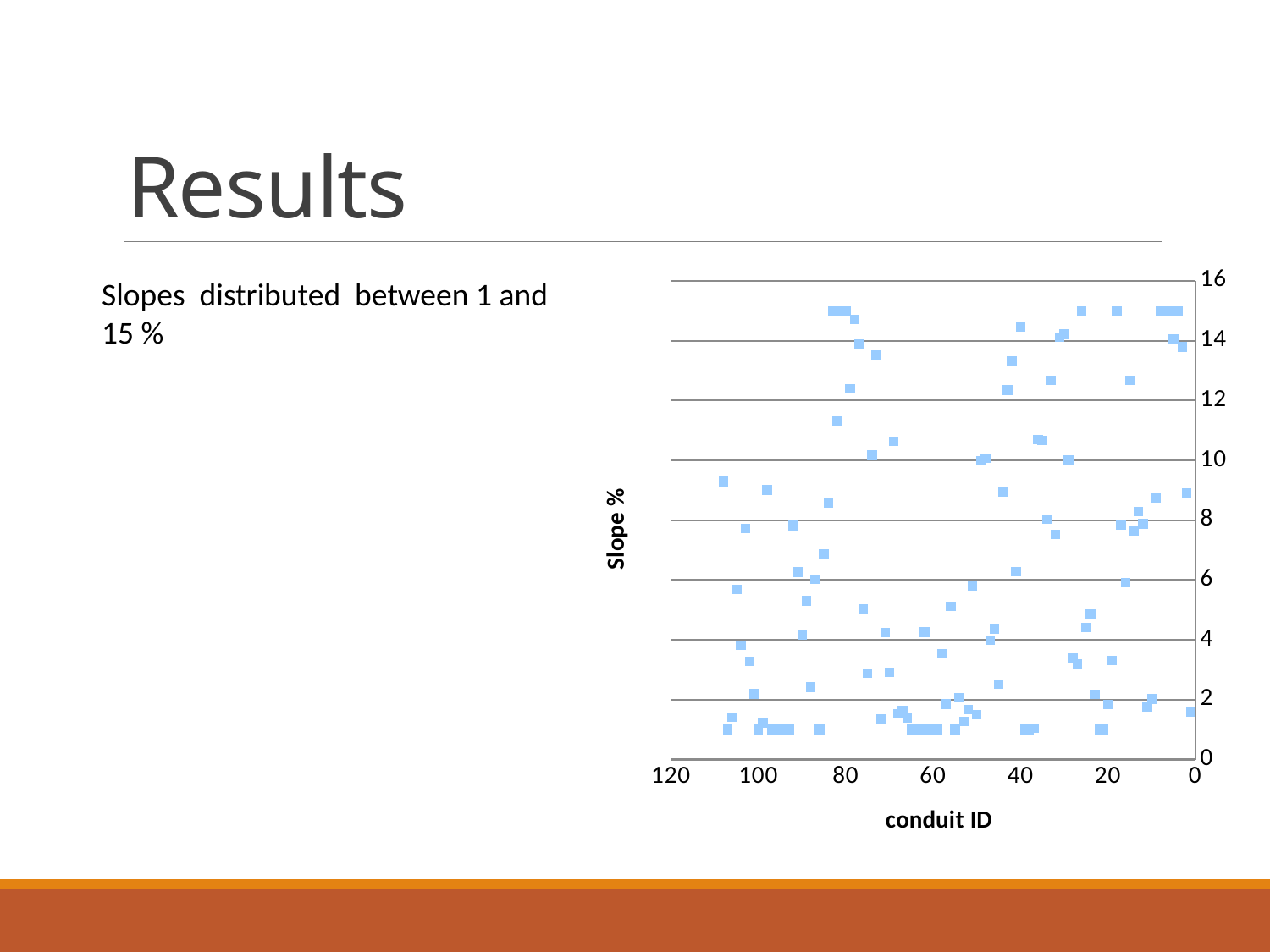
What is the label of the x axis of the chart? conduit ID Does the x axis of the chart run in increasing or decreasing order from left to right? decreasing Is the highest plotted slope value greater or less than 14? greater Are any plotted slope values greater than 16? no Is the lowest plotted slope value greater or less than 2? less What kind of chart is shown on the slide? scatter chart What is the label of the y axis of the chart? Slope % How many data series are plotted in the chart? 1